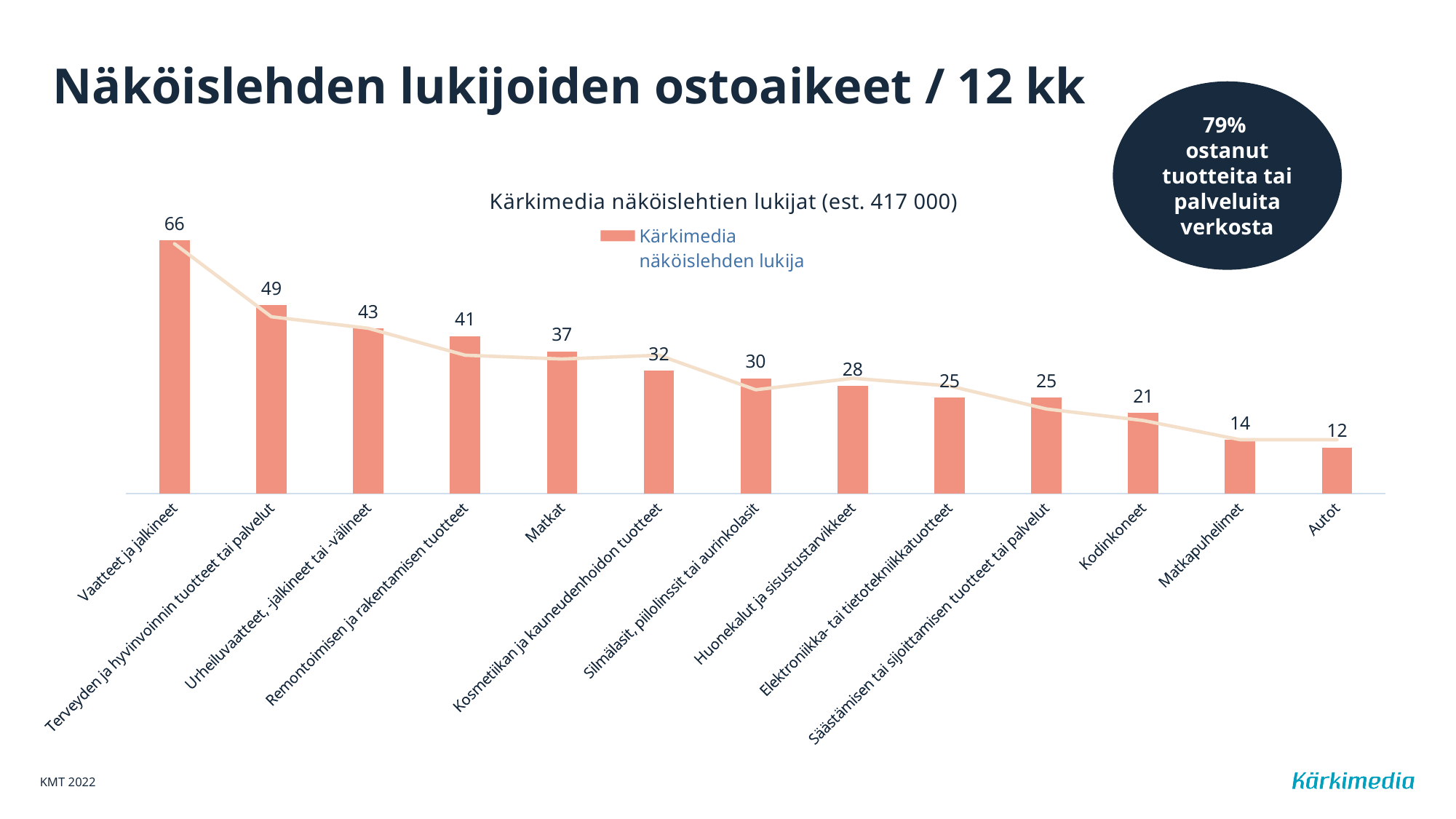
What kind of chart is this? Combination bar and line chart Which category has the highest value? Vaatteet ja jalkineet What is the difference between the values for Terveyden ja hyvinvoinnin tuotteet tai palvelut and Urheiluvaatteet, -jalkineet tai -välineet? 6 What is the difference between the values for Vaatteet ja jalkineet and Autot? 54 Which is larger, the value for Matkapuhelimet or the value for Kodinkoneet? Kodinkoneet Which category has the lowest value? Autot What is the value for Kodinkoneet? 21 What is the value for Vaatteet ja jalkineet? 66 How many series does the legend list? 1 Do the values rise or fall from left to right along the x axis? Fall How many categories are shown on the x axis? 13 What is the value for Matkat? 37